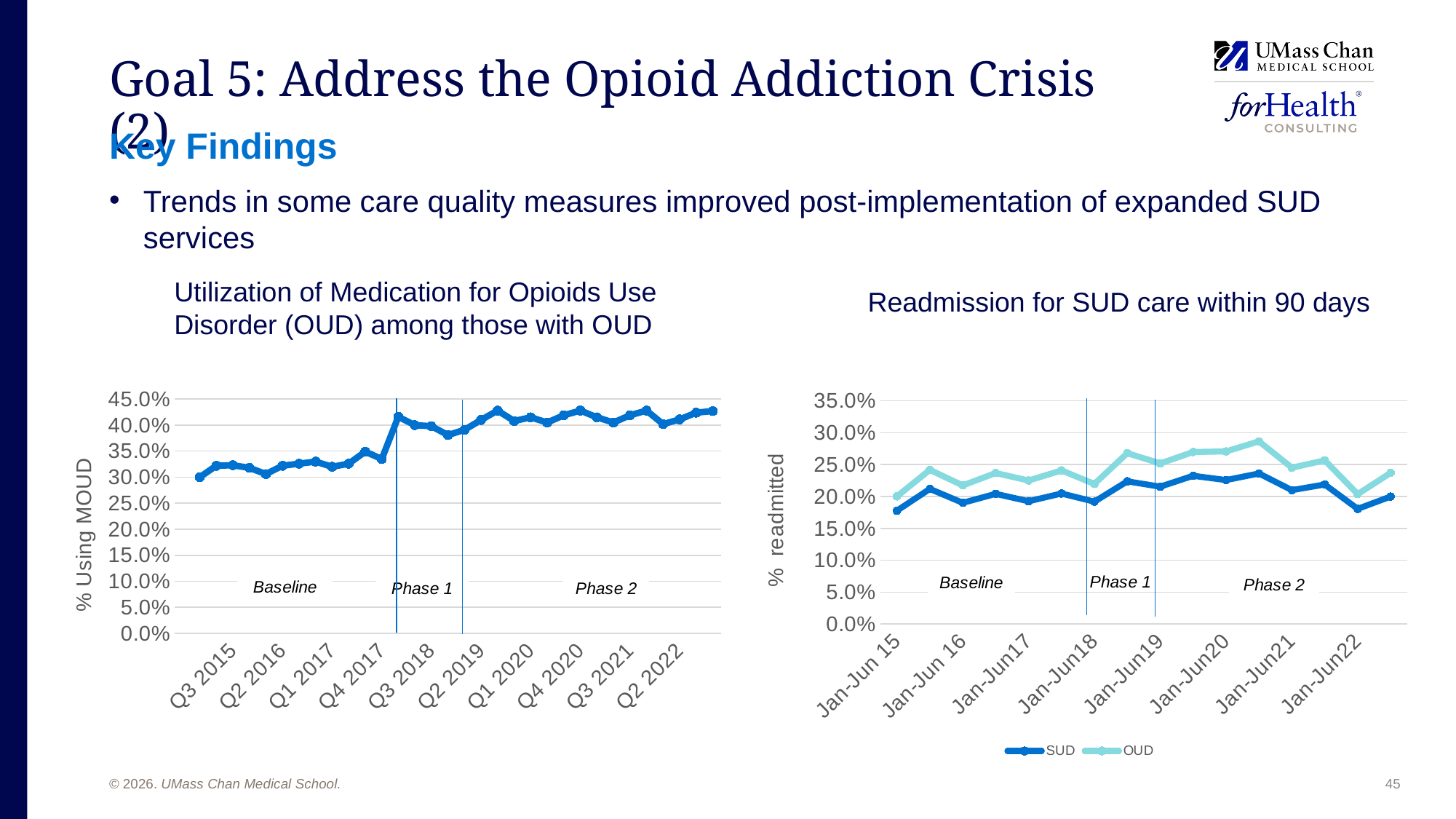
In the 'Readmission for SUD care within 90 days' chart, does the OUD line rise or fall from Jan-Jun21 to Jan-Jun22? Fall In the 'Utilization of Medication for Opioids Use Disorder (OUD) among those with OUD' chart, is the value at Q2 2022 greater or less than 40.0%? greater What are the three phase labels shown on the 'Readmission for SUD care within 90 days' chart? Baseline, Phase 1, Phase 2 In the 'Readmission for SUD care within 90 days' chart, which series is higher at Jan-Jun21, SUD or OUD? OUD What kind of chart is the 'Readmission for SUD care within 90 days' chart? Line chart What is the y-axis title of the 'Utilization of Medication for Opioids Use Disorder (OUD) among those with OUD' chart? % Using MOUD In the 'Readmission for SUD care within 90 days' chart, is the SUD value at Jan-Jun 15 greater or less than 20.0%? less In the 'Utilization of Medication for Opioids Use Disorder (OUD) among those with OUD' chart, is the value at Q3 2015 greater or less than 25.0%? greater In the 'Utilization of Medication for Opioids Use Disorder (OUD) among those with OUD' chart, do values overall rise or fall from Q3 2015 to Q2 2022? Rise What kind of chart is the 'Utilization of Medication for Opioids Use Disorder (OUD) among those with OUD' chart? Line chart How many series does the legend of the 'Readmission for SUD care within 90 days' chart list? 2